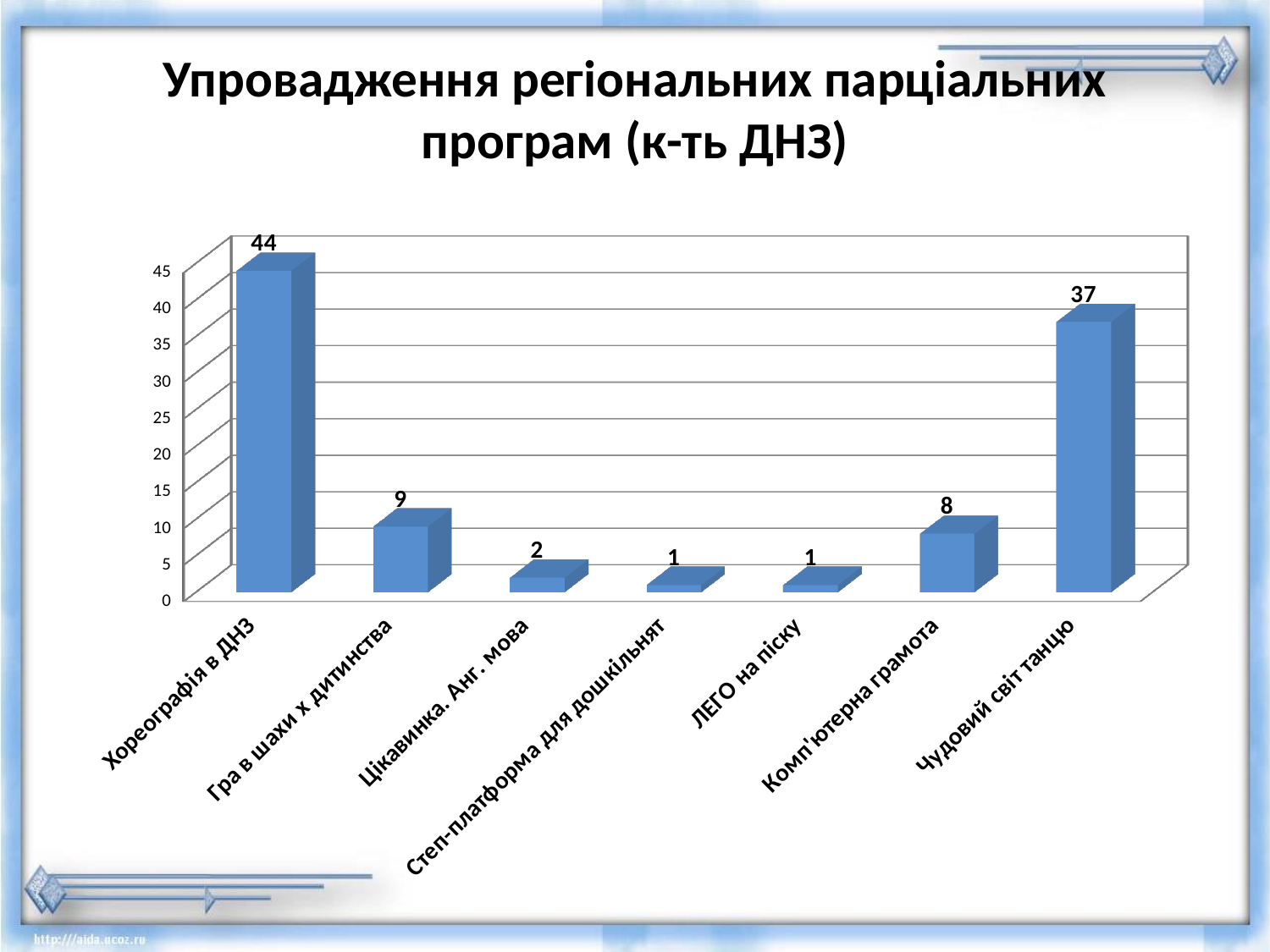
What kind of chart is shown on the slide? bar chart What is the difference between the values for Хореографія в ДНЗ and Чудовий світ танцю? 7 Which category has the highest value? Хореографія в ДНЗ What is the value for Чудовий світ танцю? 37 Which is larger, the value for Гра в шахи х дитинства or the value for Комп'ютерна грамота? Гра в шахи х дитинства What is the value for Гра в шахи х дитинства? 9 How many categories are shown in the chart? 7 What is the value for Хореографія в ДНЗ? 44 What is the value for Комп'ютерна грамота? 8 Is the value for Чудовий світ танцю greater or less than 35? greater What is the value for Цікавинка. Анг. мова? 2 What is the title of the chart? Упровадження регіональних парціальних програм (к-ть ДНЗ)